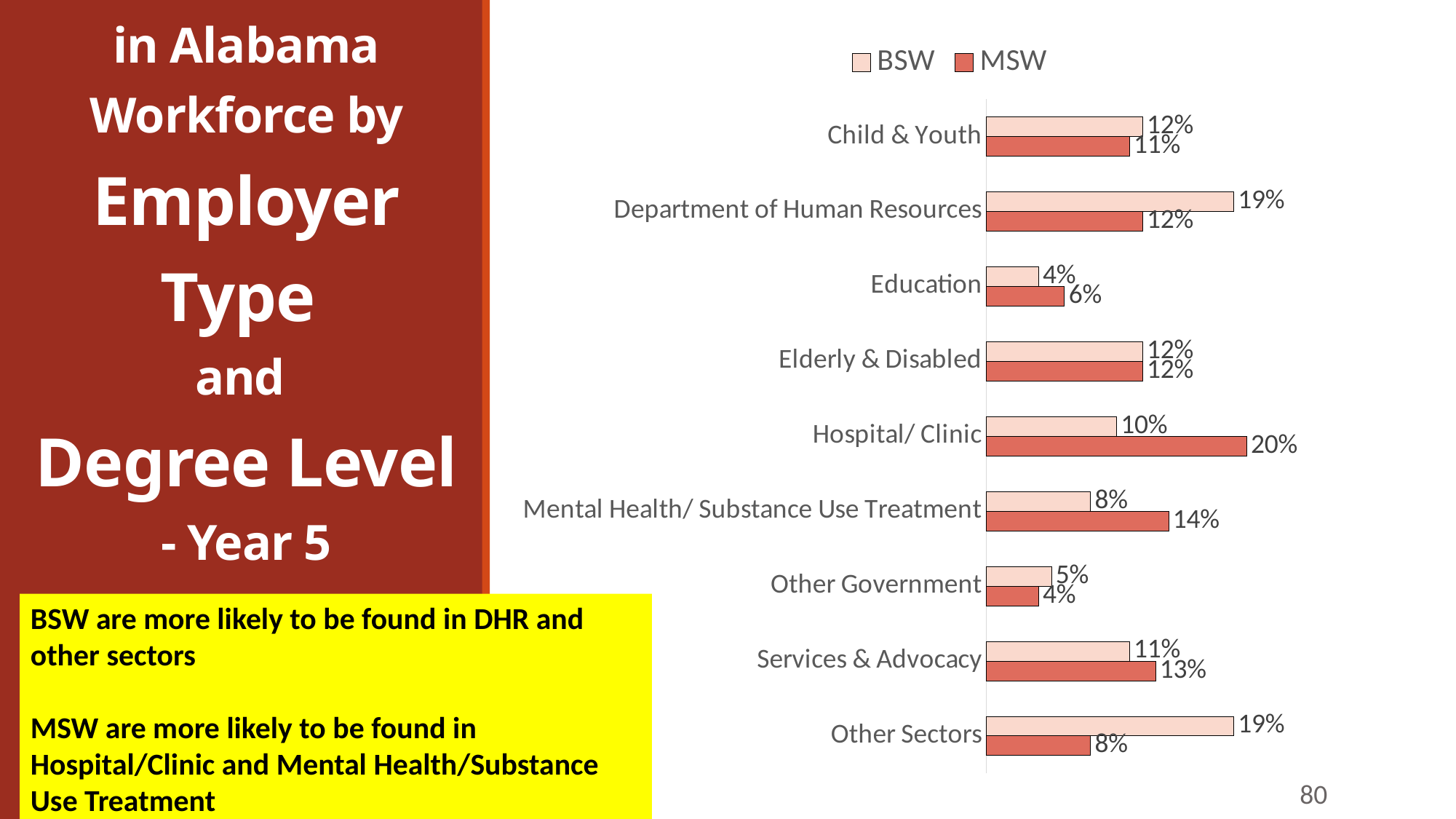
What kind of chart is shown on the slide? Bar chart How many employer type categories are shown in the chart? 9 Which series is shown in the darker red colour? MSW How many series does the legend list? 2 What is the MSW value for Mental Health/ Substance Use Treatment? 14% What is the BSW value for Other Sectors? 19% What is the BSW value for Department of Human Resources? 19% Which category has the highest MSW value? Hospital/ Clinic Which category has the lowest BSW value? Education What is the MSW value for Hospital/ Clinic? 20% What is the difference between the MSW and BSW values for Hospital/ Clinic? 10% Which is larger for Other Sectors, the BSW value or the MSW value? BSW